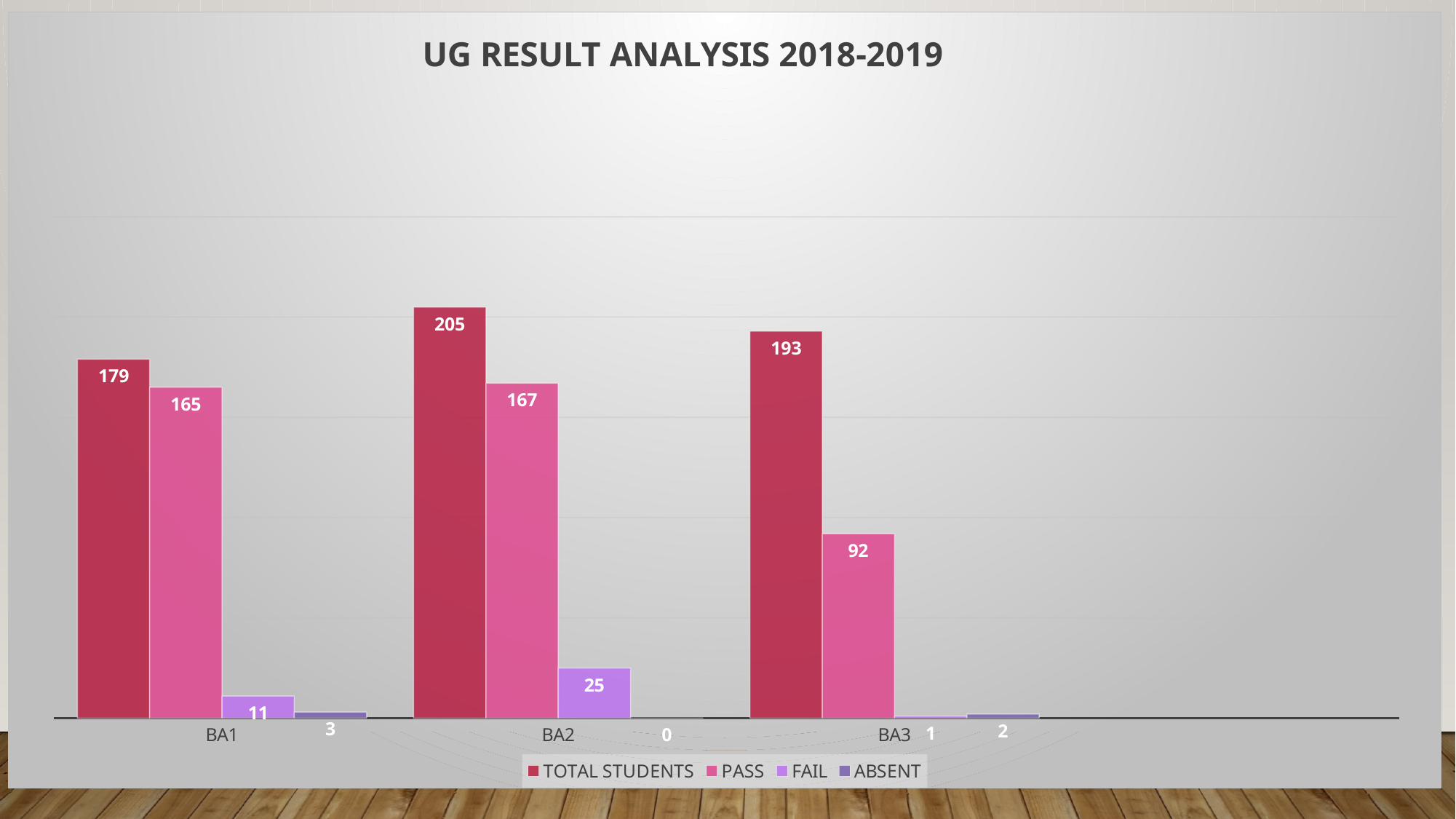
How many series does the legend list? 4 What is the TOTAL STUDENTS value for BA2? 205 What is the title of the chart? UG RESULT ANALYSIS 2018-2019 What is the PASS value for BA3? 92 Which category has the highest TOTAL STUDENTS value? BA2 What is the FAIL value for BA2? 25 What is the ABSENT value for BA1? 3 Which is larger, the PASS value for BA1 or the PASS value for BA2? BA2 Which category has the lowest PASS value? BA3 What kind of chart is shown on the slide? Bar chart What is the difference between TOTAL STUDENTS and PASS for BA3? 101 How many categories are shown on the x axis? 3